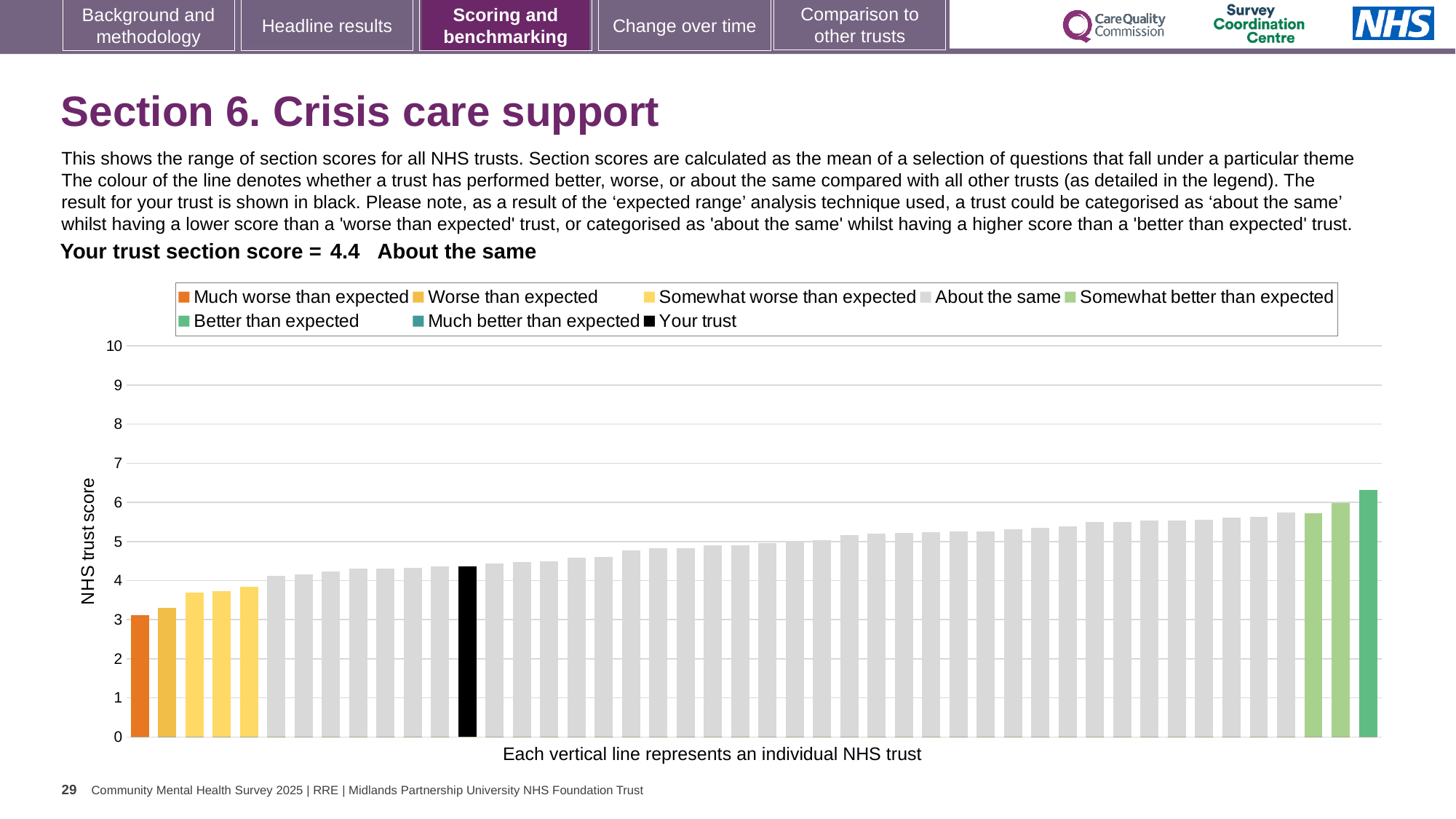
Do the bar values rise or fall from left to right along the x axis? rise How many entries does the chart legend list? 8 How many bars are coloured as 'Somewhat better than expected'? 2 What kind of chart is shown on the slide? bar chart Which legend category does the tallest bar belong to? Better than expected Is the value of the shortest bar greater or less than 4? less Which legend category does the shortest bar belong to? Much worse than expected What is the section score for your trust shown on the slide? 4.4 How many bars are coloured as 'Somewhat worse than expected'? 3 Is the value for your trust (the black bar) greater or less than 5? less Is the value of the tallest bar greater or less than 6? greater What is the label on the vertical axis of the chart? NHS trust score